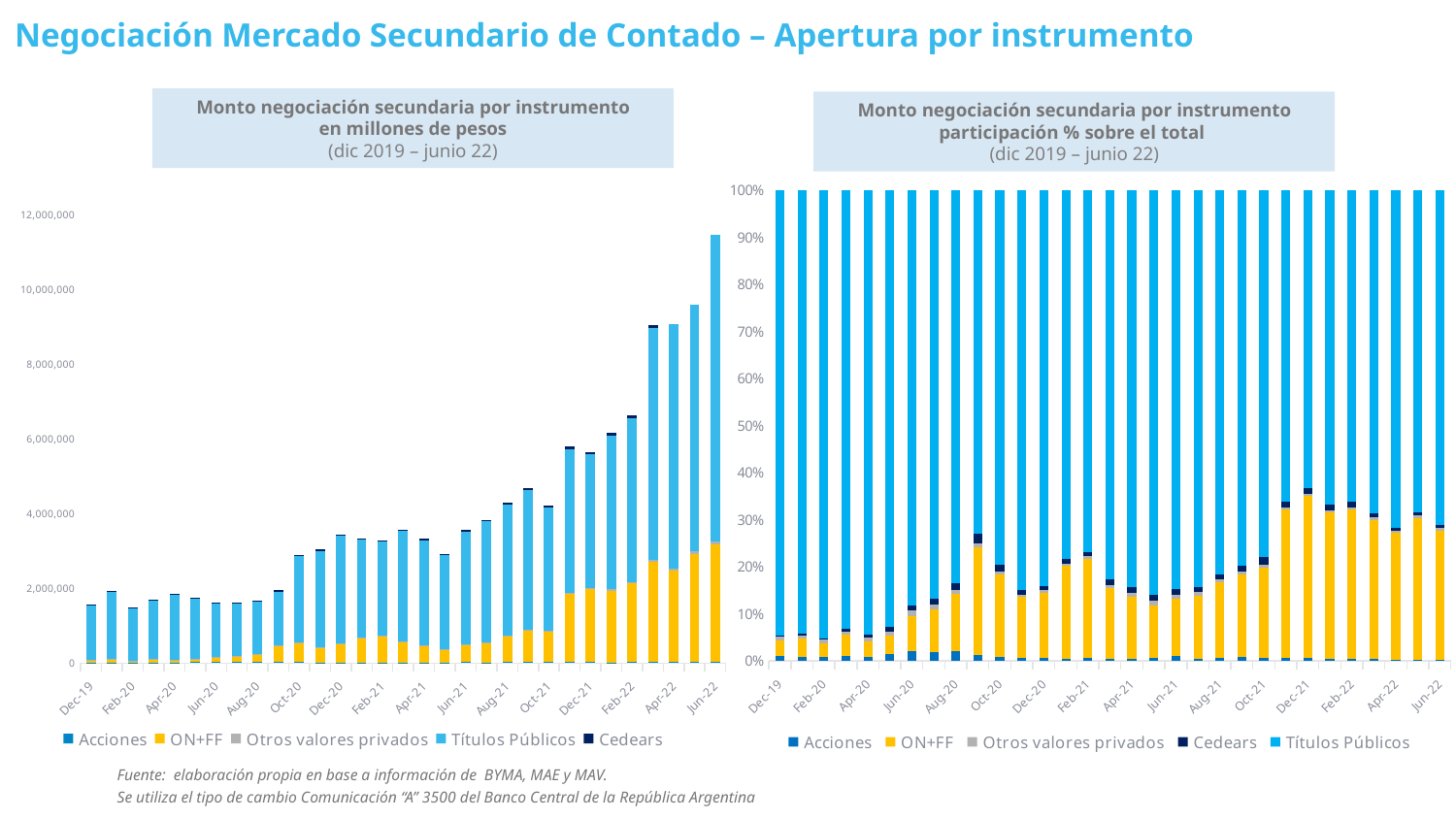
In the right chart (participación % sobre el total), what is the total of each stacked bar? 100% In the left chart (en millones de pesos), is the total for Dec-19 greater or less than 2,000,000? less In the left chart (en millones de pesos), do the total bars generally rise or fall from Dec-19 to Jun-22? Rise Which series is shown in yellow in both charts' legends? ON+FF In the left chart (en millones de pesos), which month has the highest total bar? Jun-22 What kind of chart is the right chart, 'participación % sobre el total'? Stacked bar chart In the left chart (en millones de pesos), which is larger, the total for Jun-22 or the total for Dec-21? Jun-22 What kind of chart is the left chart, 'Monto negociación secundaria por instrumento en millones de pesos'? Stacked bar chart In the right chart (participación % sobre el total), is the ON+FF share for Jun-22 greater or less than 20%? greater In the right chart (participación % sobre el total), is the ON+FF share for Dec-19 greater or less than 10%? less How many series does the legend of the left chart list? 5